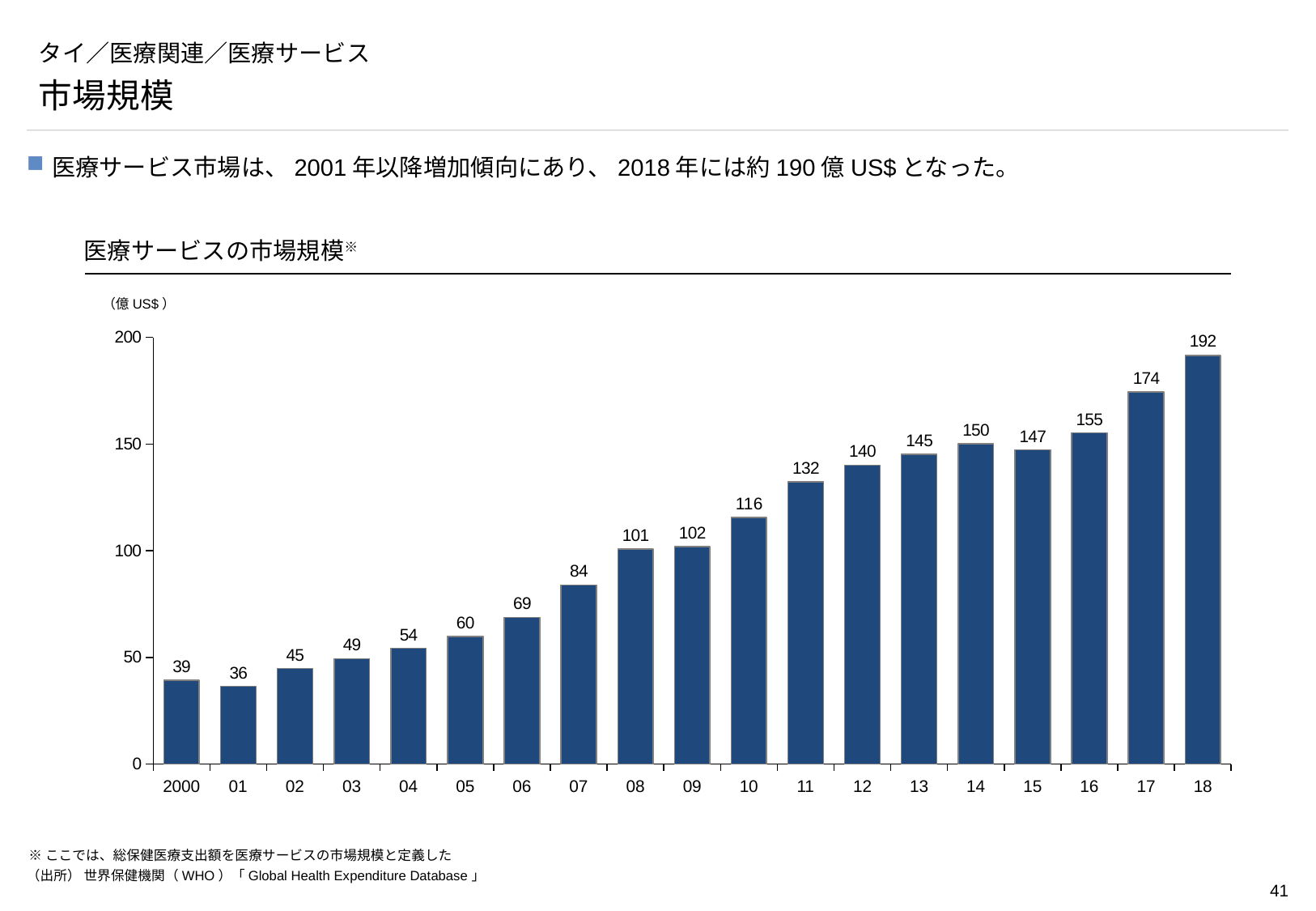
What kind of chart is shown on the slide? bar chart Which year has the highest value in the chart? 18 How many years (bars) are shown in the chart? 19 What is the difference between the values for 2000 and 01? 3 Which year has the lowest value in the chart? 01 What unit is shown for the values in the chart? 億 US$ Is the value for 10 greater or less than 100? greater What is the difference between the values for 18 and 17? 18 What is the value for 2018 in the 医療サービスの市場規模 chart? 192 What is the value for 08 (2008) in the chart? 101 Which is larger, the value for 14 or the value for 15? 14 What is the value for 2000 in the chart? 39